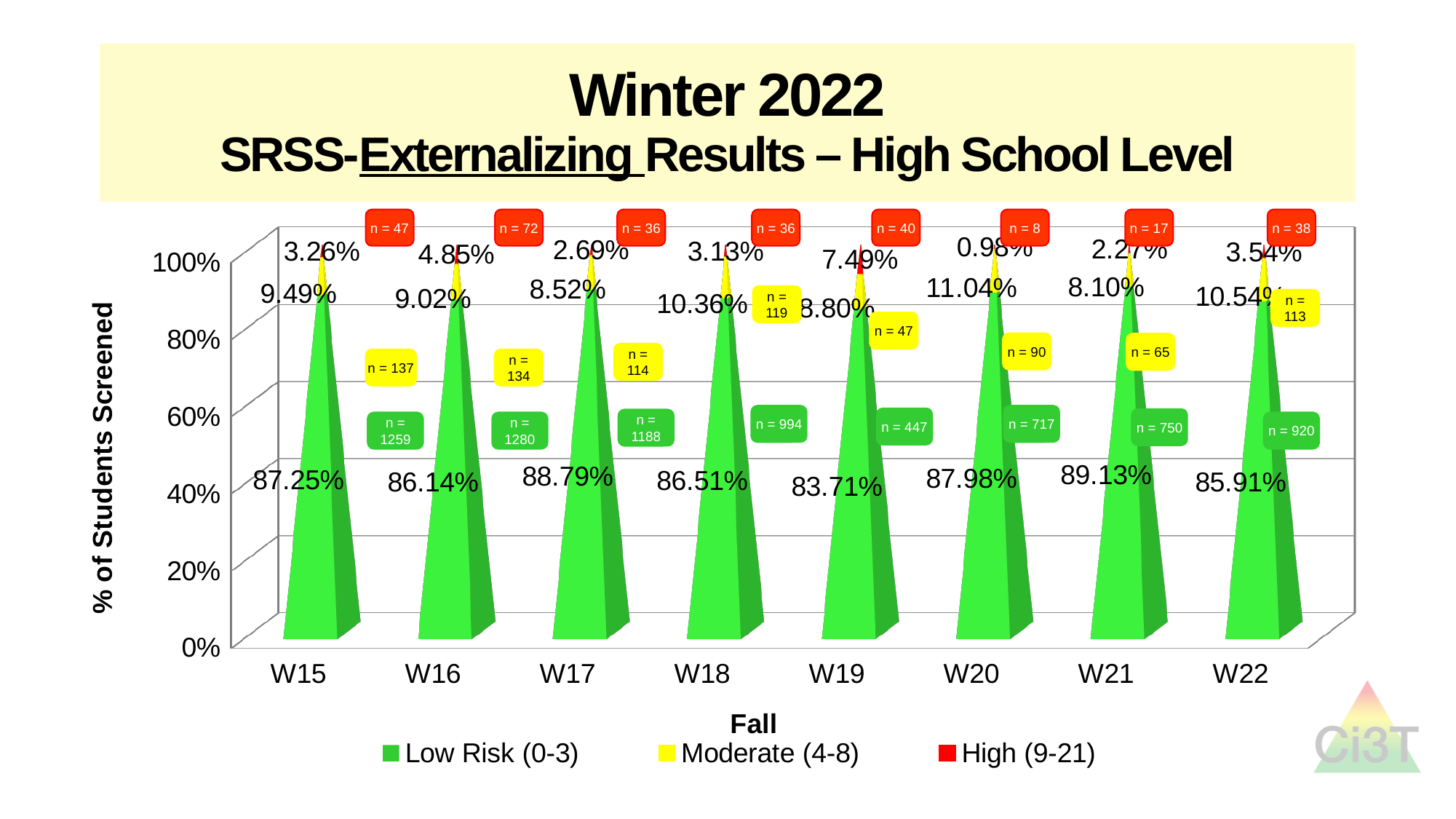
What is the label of the y axis? % of Students Screened What is the Low Risk (0-3) percentage for W21? 89.13% What is the High (9-21) percentage for W19? 7.49% How many series does the legend list? 3 Which is larger, the High (9-21) percentage for W16 or for W15? W16 Which screening period has the lowest Low Risk (0-3) percentage? W19 What is the Moderate (4-8) percentage for W20? 11.04% What is the difference between the Low Risk (0-3) percentages for W21 and W19? 5.42 percentage points How many screening periods are shown on the x axis? 8 What is the n value shown for the Low Risk (0-3) group in W16? n = 1280 Which screening period has the lowest High (9-21) percentage? W20 Which screening period has the highest Low Risk (0-3) percentage? W21